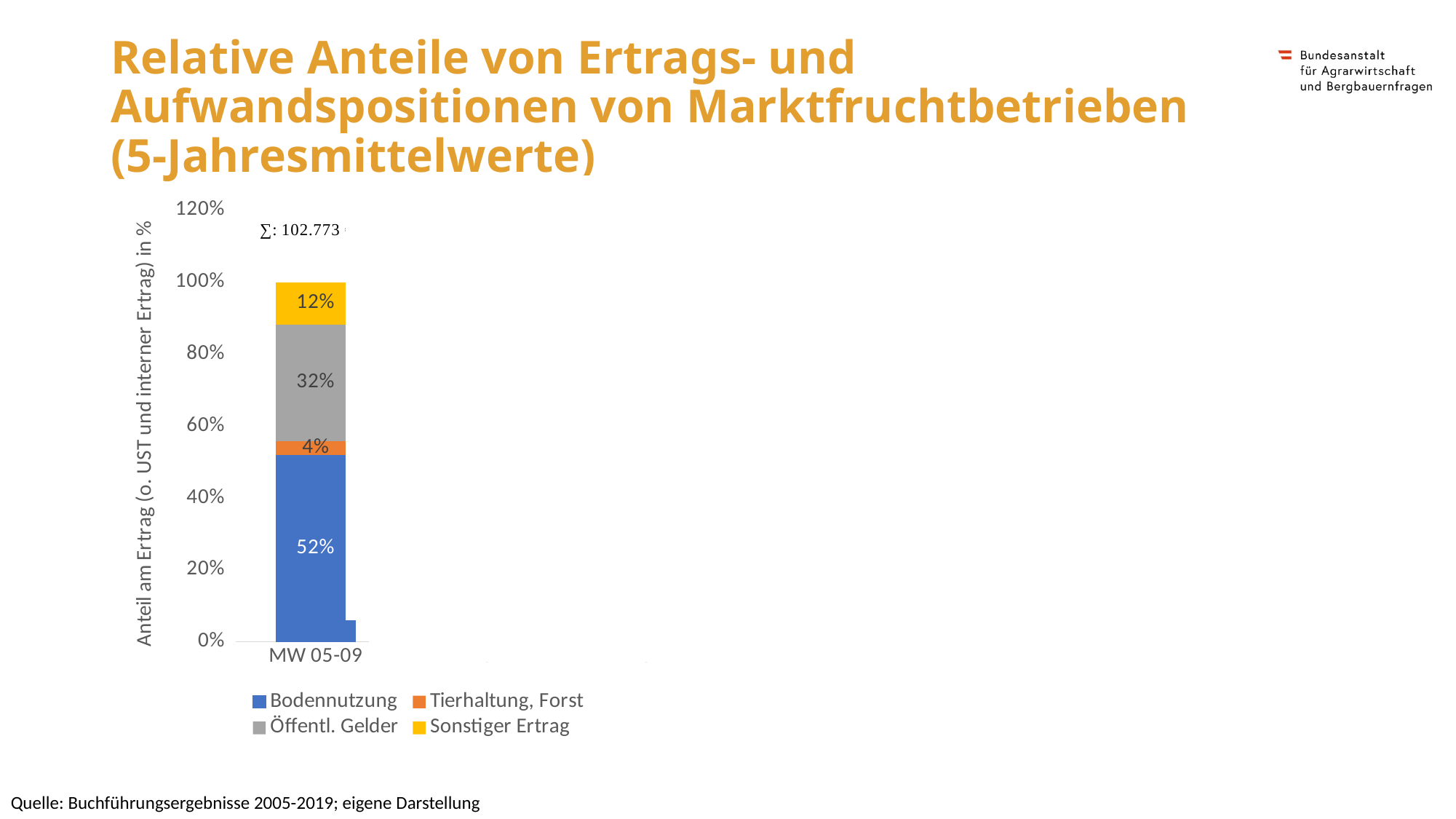
What is the sum value printed above the MW 05-09 bar? ∑: 102.773 What kind of chart is shown on the slide? Stacked bar chart Which series has the largest share in the MW 05-09 bar? Bodennutzung What is the value for Bodennutzung in the MW 05-09 bar? 52% How many series does the legend list? 4 Which is larger in the MW 05-09 bar, Öffentl. Gelder or Sonstiger Ertrag? Öffentl. Gelder What is the difference between the Bodennutzung and Öffentl. Gelder shares in the MW 05-09 bar? 20% What is the value for Tierhaltung, Forst in the MW 05-09 bar? 4% What is the value for Sonstiger Ertrag in the MW 05-09 bar? 12% What is the value for Öffentl. Gelder in the MW 05-09 bar? 32% What is the category label on the x axis? MW 05-09 Which series has the smallest share in the MW 05-09 bar? Tierhaltung, Forst